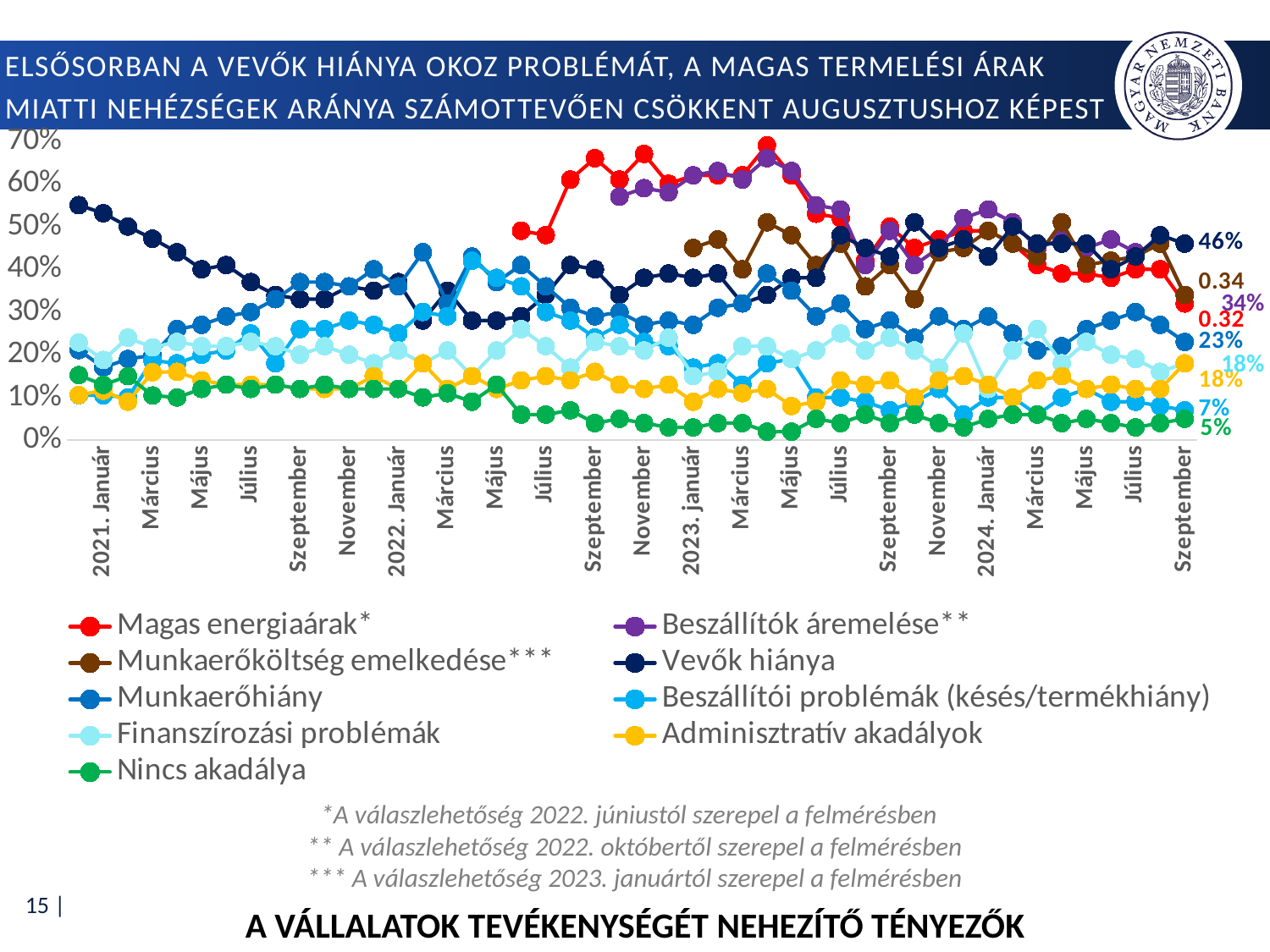
What is the value for Beszállítói problémák (késés/termékhiány) in September 2024? 7% What is the value for Vevők hiánya in September 2024? 46% Which series has the lowest value in September 2024? Nincs akadálya What is the title of the chart? A vállalatok tevékenységét nehezítő tényezők What is the value for Nincs akadálya in September 2024? 5% What is the difference between Vevők hiánya and Munkaerőhiány in September 2024? 23 percentage points In September 2024, which is larger: Munkaerőhiány or Nincs akadálya? Munkaerőhiány Which series has the highest value in September 2024? Vevők hiánya Is the value for Vevők hiánya in 2021 January greater or less than 50%? greater What type of chart is shown on the slide? Line chart How many series does the legend list? 9 What is the value for Munkaerőhiány in September 2024? 23%